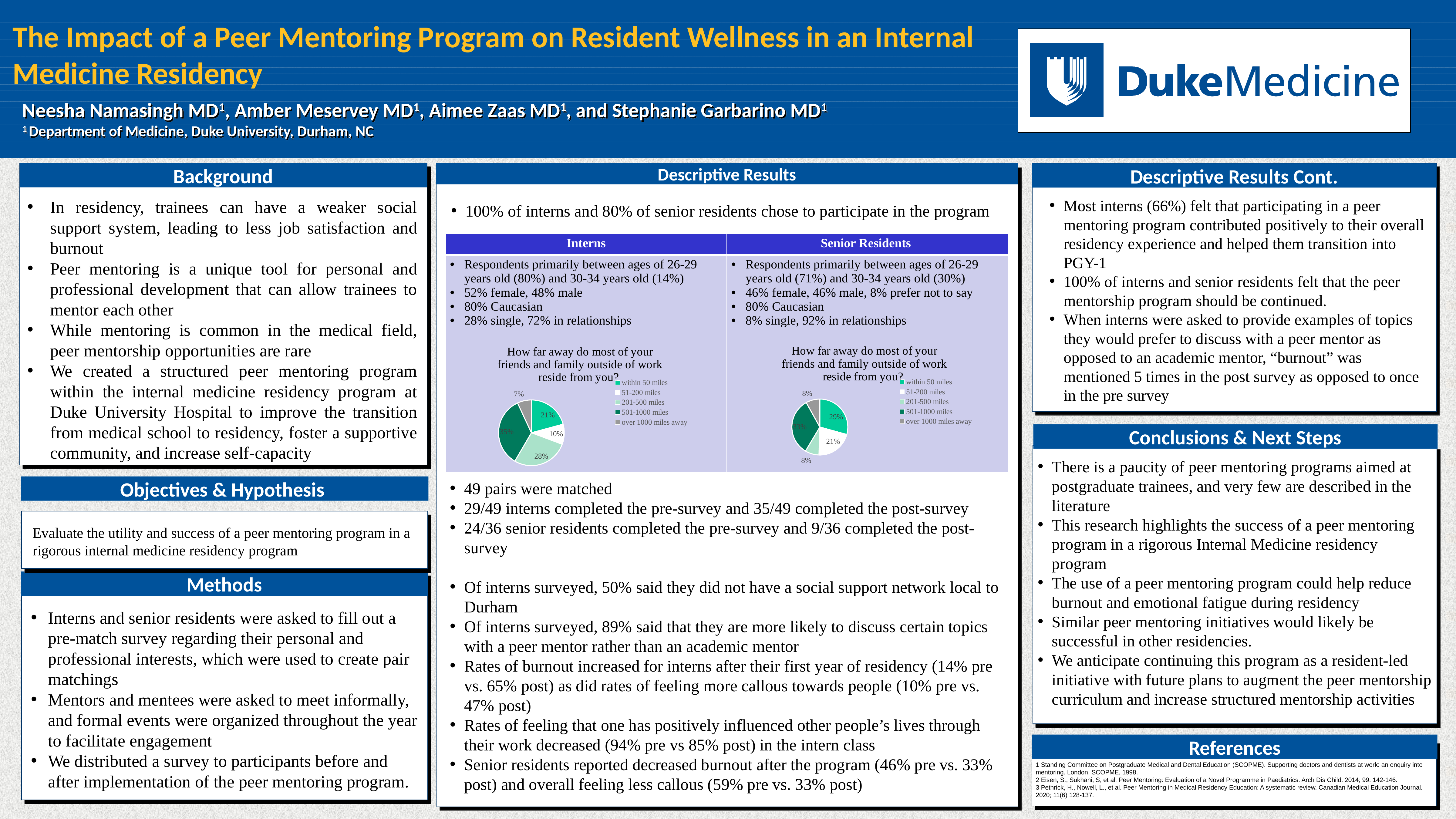
In the Senior Residents pie chart, what percentage corresponds to over 1000 miles away? 8% In the Interns pie chart, how many percentage points larger is the 201-500 miles share than the 51-200 miles share? 18 percentage points Which group has a larger share of respondents with friends and family within 50 miles, Interns or Senior Residents? Senior Residents In the Interns pie chart, what percentage of respondents have friends and family within 50 miles? 21% In the Senior Residents pie chart, what percentage of respondents have friends and family within 50 miles? 29% In the Interns pie chart, what percentage corresponds to 51-200 miles? 10% What kind of chart is used under "How far away do most of your friends and family outside of work reside from you?" for Interns? Pie chart In the Interns pie chart, what percentage corresponds to over 1000 miles away? 7% In the Interns pie chart, what percentage corresponds to 201-500 miles? 28% In the Interns pie chart, which distance category has the smallest share? over 1000 miles away In the Senior Residents pie chart, what percentage corresponds to 51-200 miles? 21% How many distance categories does the legend of the Interns pie chart list? 5